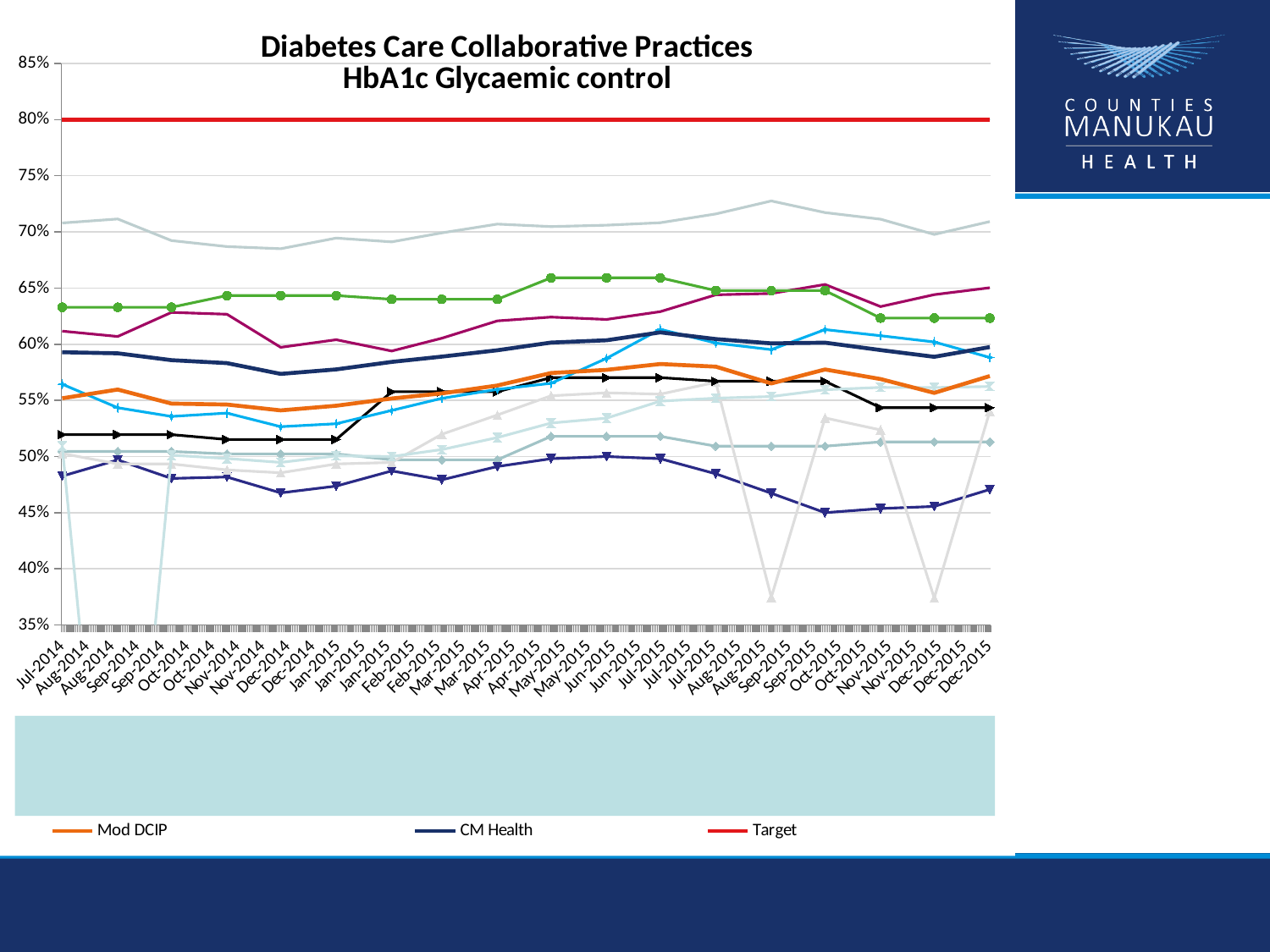
In Jul-2014, which is higher: Mod DCIP or CM Health? CM Health What colour is the Target line? Red Is the value for CM Health in Jul-2014 greater or less than 55%? greater What value does the Target line sit at? 80% Of the three series named in the legend, which has the highest values across the whole period? Target In Dec-2015, which is higher: Mod DCIP or CM Health? CM Health What is the title of the chart? Diabetes Care Collaborative Practices HbA1c Glycaemic control Does the Target line rise, fall, or stay flat across the x axis? Stays flat Is the value for Mod DCIP in Dec-2015 greater or less than 60%? less How many series does the legend list? 3 What type of chart is shown on the slide? Line chart Is the value for Mod DCIP in Jul-2014 greater or less than 60%? less